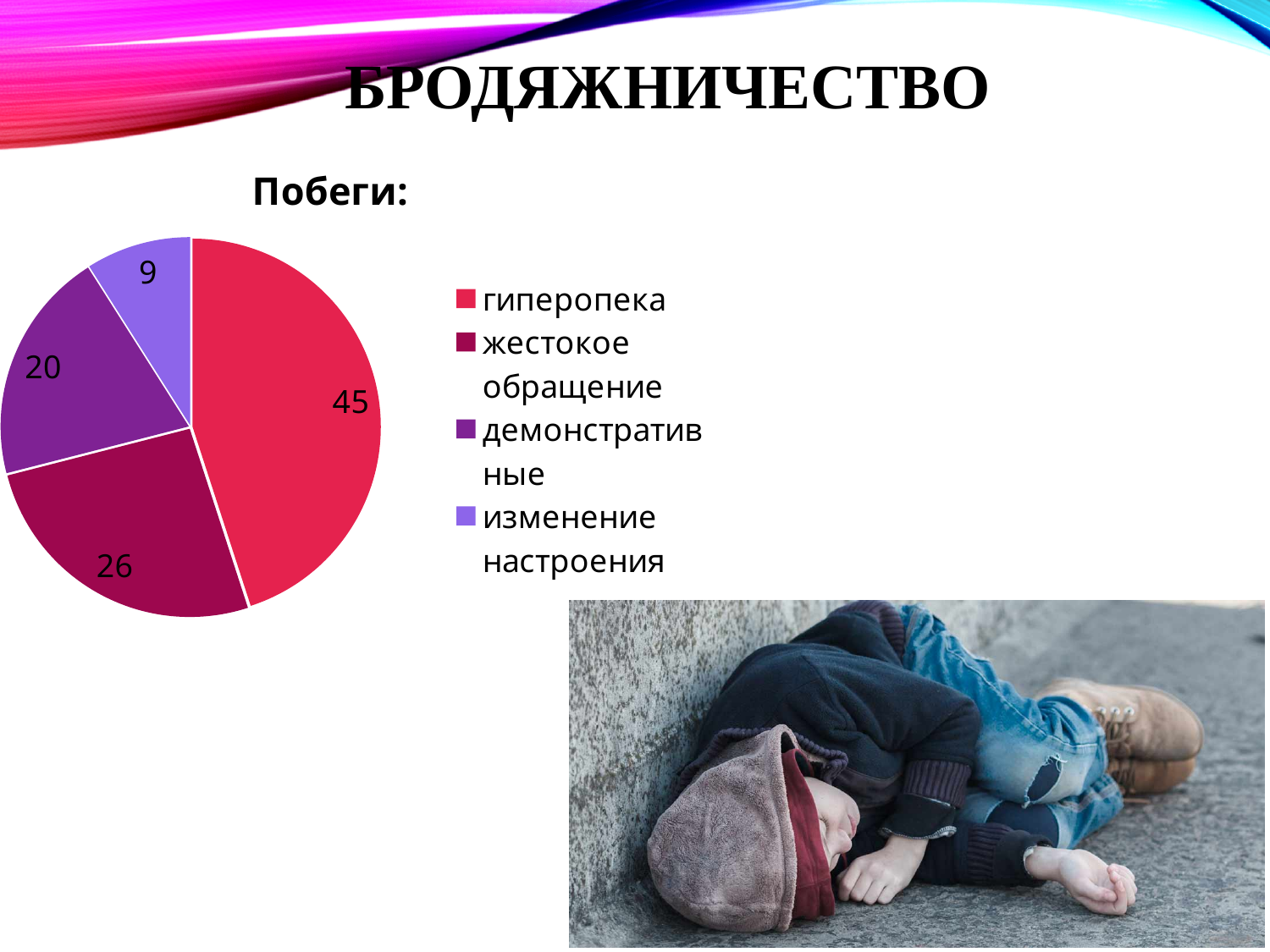
What is the value for жестокое обращение? 26 What share of the pie does гиперопека represent? 45% Which category has the largest slice? гиперопека What is the difference between the values for гиперопека and жестокое обращение? 19 What is the value for демонстративные? 20 What is the value for гиперопека? 45 What is the value for изменение настроения? 9 Which category has the smallest slice? изменение настроения What type of chart is shown on the slide? pie chart How many categories does the pie chart have? 4 What is the title of the chart? Побеги: Which is larger, демонстративные or изменение настроения? демонстративные